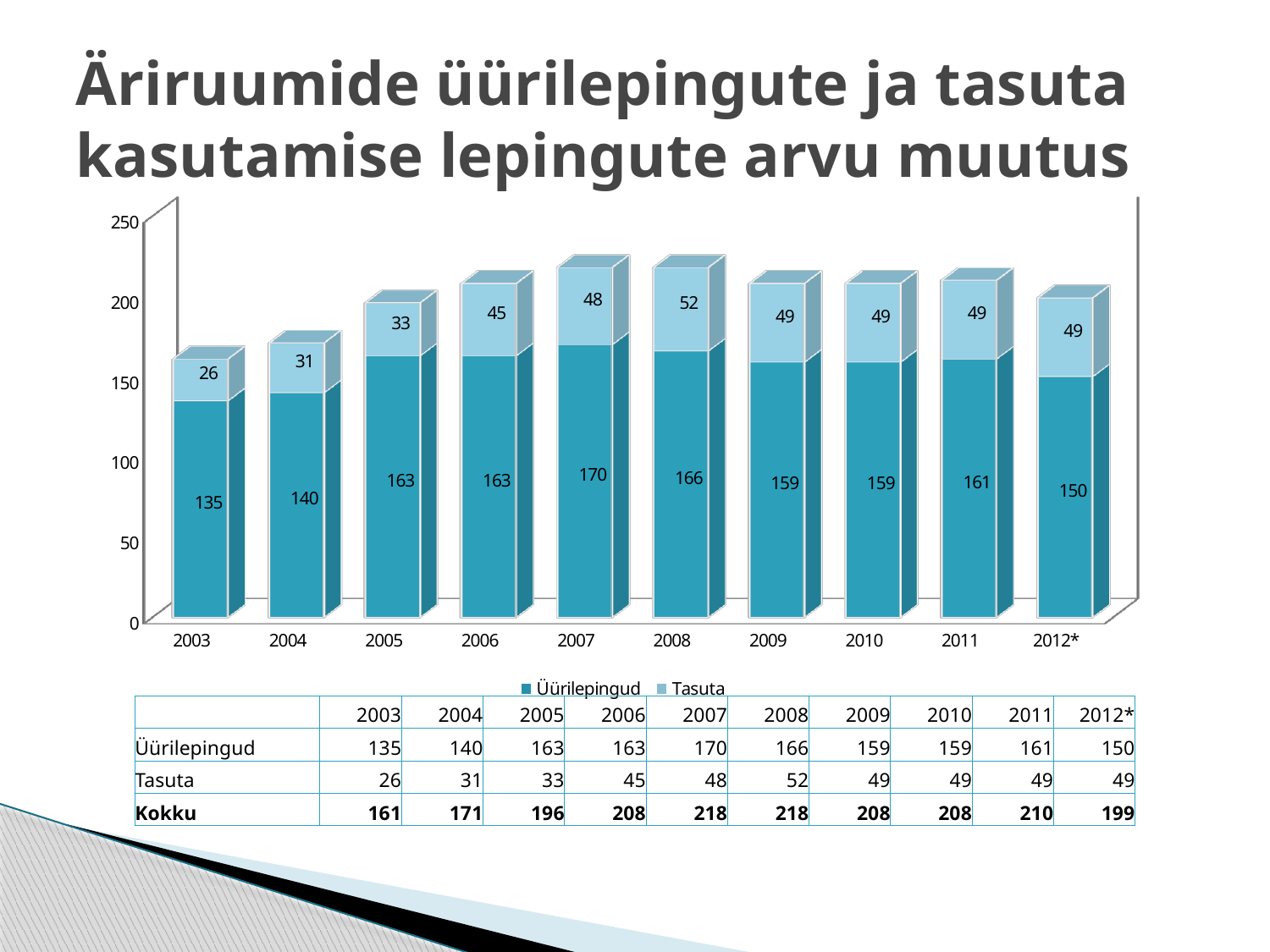
What is the total of the stacked bar for 2012*? 199 Which year has the lowest Tasuta value? 2003 What is the total of the stacked bar for 2007? 218 What is the difference between the Üürilepingud values for 2005 and 2012*? 13 What kind of chart is shown on the slide? Stacked bar chart Which is larger, the Tasuta value for 2008 or for 2006? 2008 How many years are shown on the x axis? 10 What is the value for Tasuta in 2004? 31 Which series is shown in the lighter blue colour? Tasuta Which year has the highest Üürilepingud value? 2007 How many series does the legend list? 2 What is the value for Üürilepingud in 2007? 170